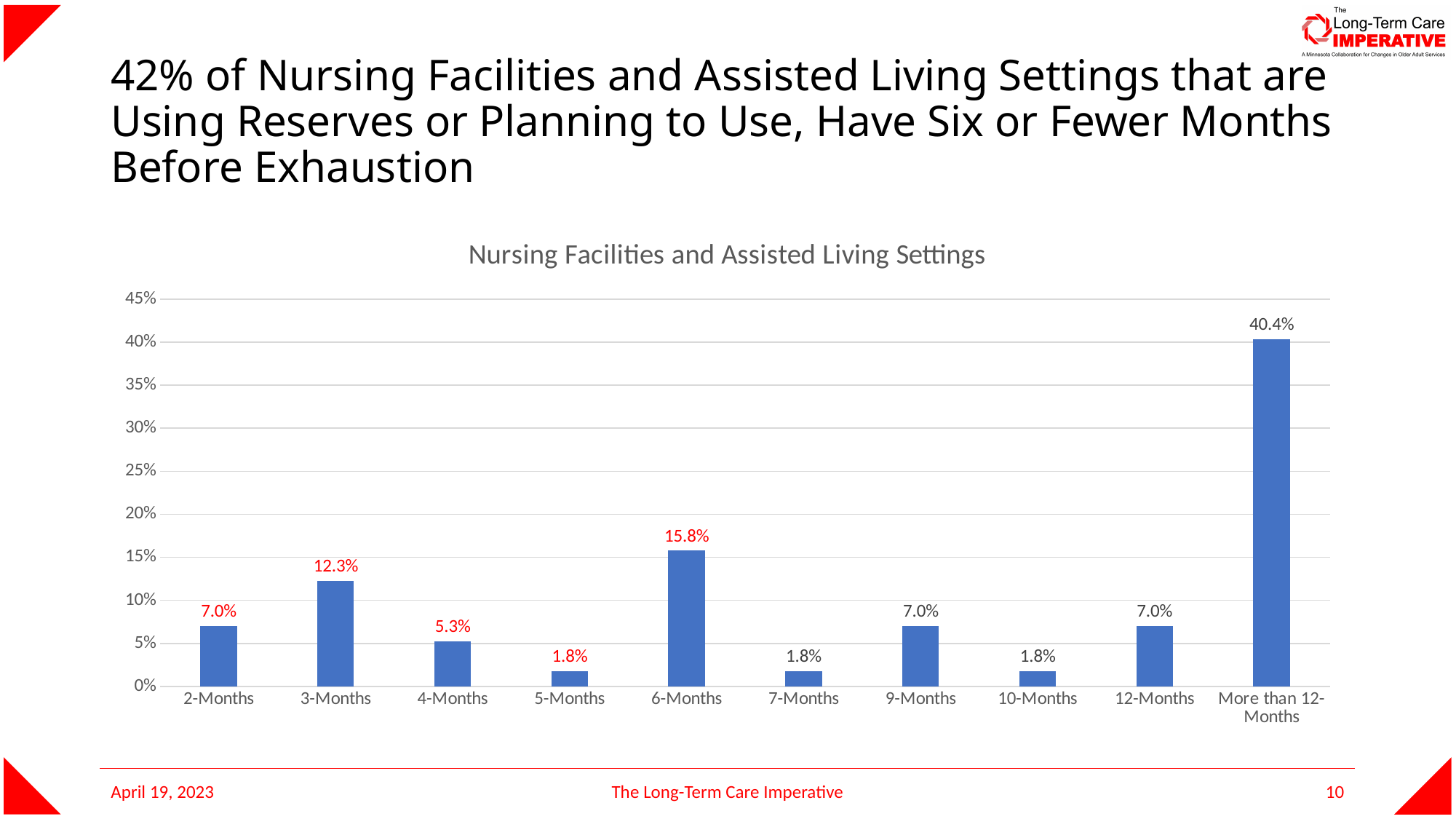
What is the value for 4-Months? 5.3% What is the difference between the values for More than 12-Months and 6-Months? 24.6% How many categories have a value of 1.8%? 3 What kind of chart is shown? bar chart What is the title of the chart? Nursing Facilities and Assisted Living Settings What is the difference between the values for 6-Months and 3-Months? 3.5% Which is larger, the value for 3-Months or the value for 9-Months? 3-Months Is the value for More than 12-Months greater or less than 35%? greater What is the value for More than 12-Months? 40.4% Which category has the highest value? More than 12-Months How many categories are shown on the x axis? 10 What is the value for 6-Months? 15.8%